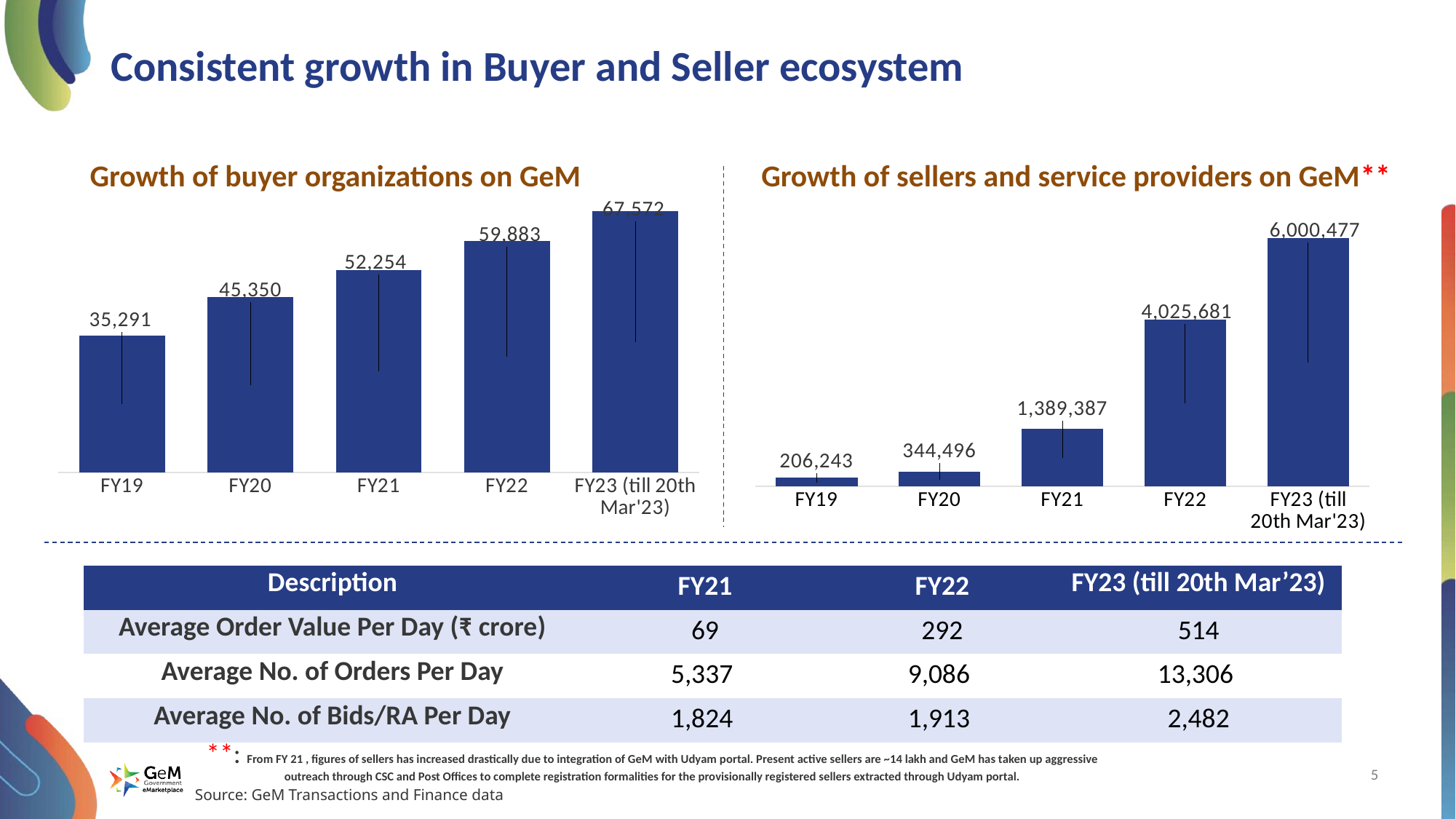
In the 'Growth of sellers and service providers on GeM' chart, which category has the lowest value? FY19 How many categories are shown in the 'Growth of buyer organizations on GeM' chart? 5 In the 'Growth of buyer organizations on GeM' chart, which category has the highest value? FY23 (till 20th Mar'23) In the 'Growth of buyer organizations on GeM' chart, what is the difference between the FY23 (till 20th Mar'23) value and the FY19 value? 32,281 In the 'Growth of sellers and service providers on GeM' chart, what is the difference between the FY23 (till 20th Mar'23) value and the FY22 value? 1,974,796 In the 'Growth of buyer organizations on GeM' chart, do the values rise or fall from FY19 to FY23 (till 20th Mar'23)? Rise What kind of chart is the 'Growth of sellers and service providers on GeM' chart? Bar chart In the 'Growth of sellers and service providers on GeM' chart, what is the value for FY22? 4,025,681 What is the title of the chart on the right side of the slide? Growth of sellers and service providers on GeM In the 'Growth of buyer organizations on GeM' chart, what is the value for FY21? 52,254 In the 'Growth of buyer organizations on GeM' chart, what is the difference between the FY22 value and the FY21 value? 7,629 In the 'Growth of sellers and service providers on GeM' chart, which is larger, the value for FY20 or the value for FY21? FY21